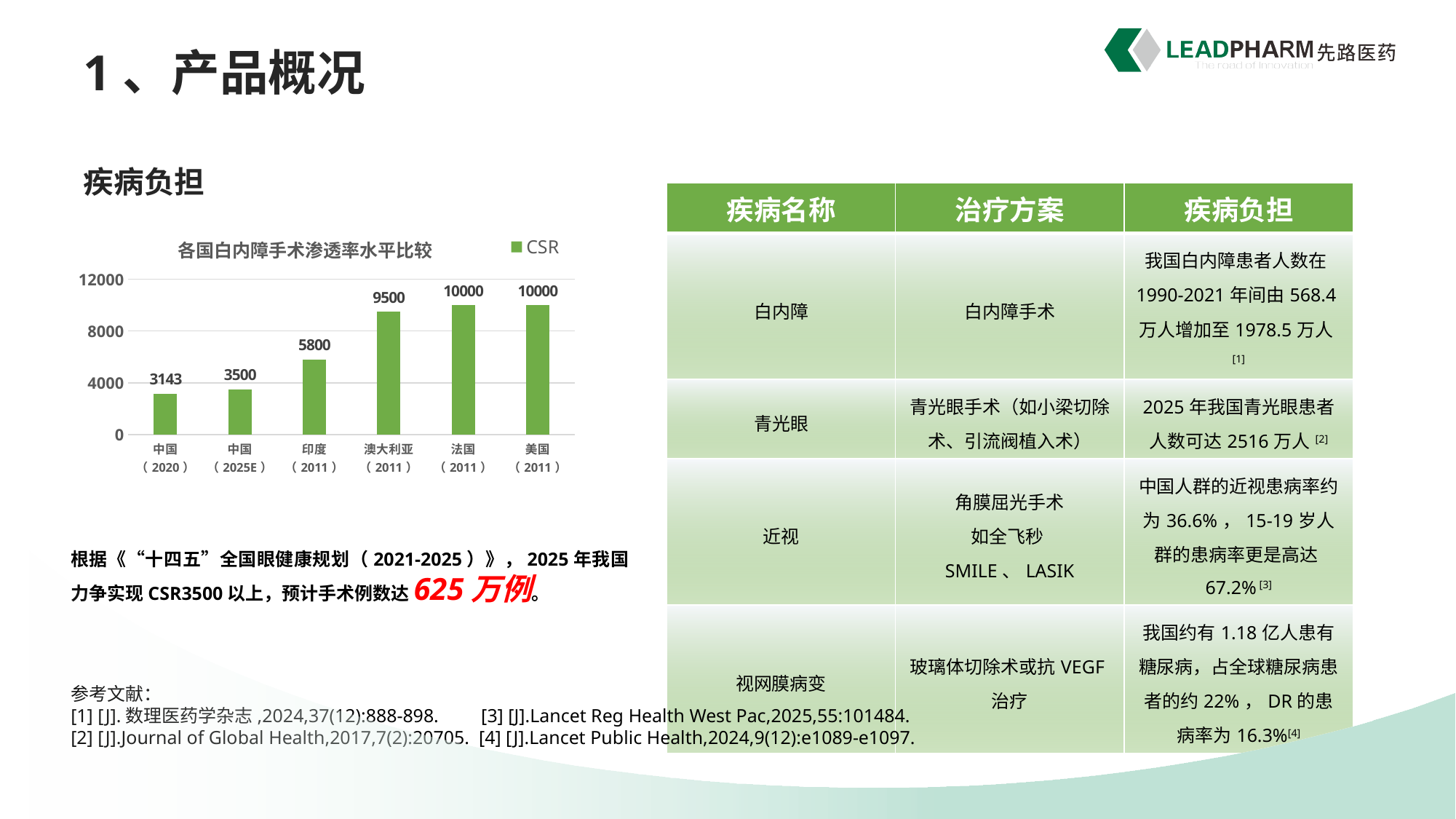
What is the difference between the CSR values for 中国（2025E） and 中国（2020）? 357 What is the difference between the CSR values for 法国（2011） and 印度（2011）? 4200 What is the CSR value for 中国（2020） in the chart? 3143 What series name is shown in the chart's legend? CSR What type of chart is 各国白内障手术渗透率水平比较? bar chart Which has a larger CSR value, 澳大利亚（2011） or 印度（2011）? 澳大利亚（2011） What is the CSR value for 中国（2025E） in the chart? 3500 What is the CSR value for 澳大利亚（2011） in the chart? 9500 Is the CSR value for 美国（2011） greater or less than 8000? greater What is the CSR value for 印度（2011） in the chart 各国白内障手术渗透率水平比较? 5800 How many categories are shown in the chart 各国白内障手术渗透率水平比较? 6 Which category has the lowest CSR value in the chart? 中国（2020）